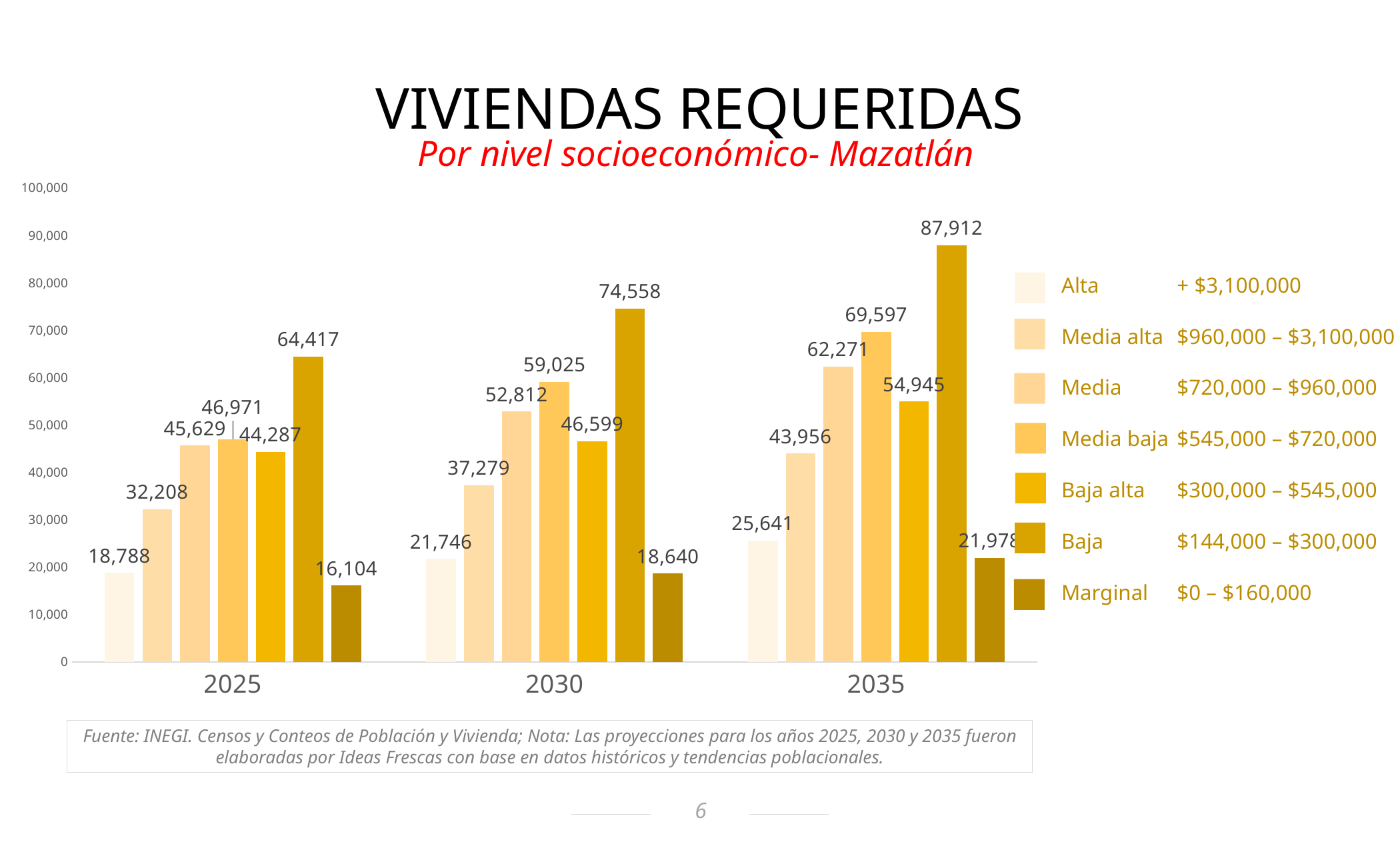
What is the value for Marginal in 2030? 18,640 What is the value for Alta in 2025? 18,788 What is the value for Baja in 2035? 87,912 How many series does the legend list? 7 What is the difference between the Baja values for 2035 and 2025? 23,495 What is the value for Media baja in 2030? 59,025 Which socioeconomic level has the highest value in 2030? Baja What kind of chart is shown on the slide? Bar chart Do the Media alta values rise or fall from 2025 to 2035? Rise Which socioeconomic level has the lowest value in 2025? Marginal Which is larger in 2025: Media or Baja alta? Media How many year categories are shown on the x axis? 3